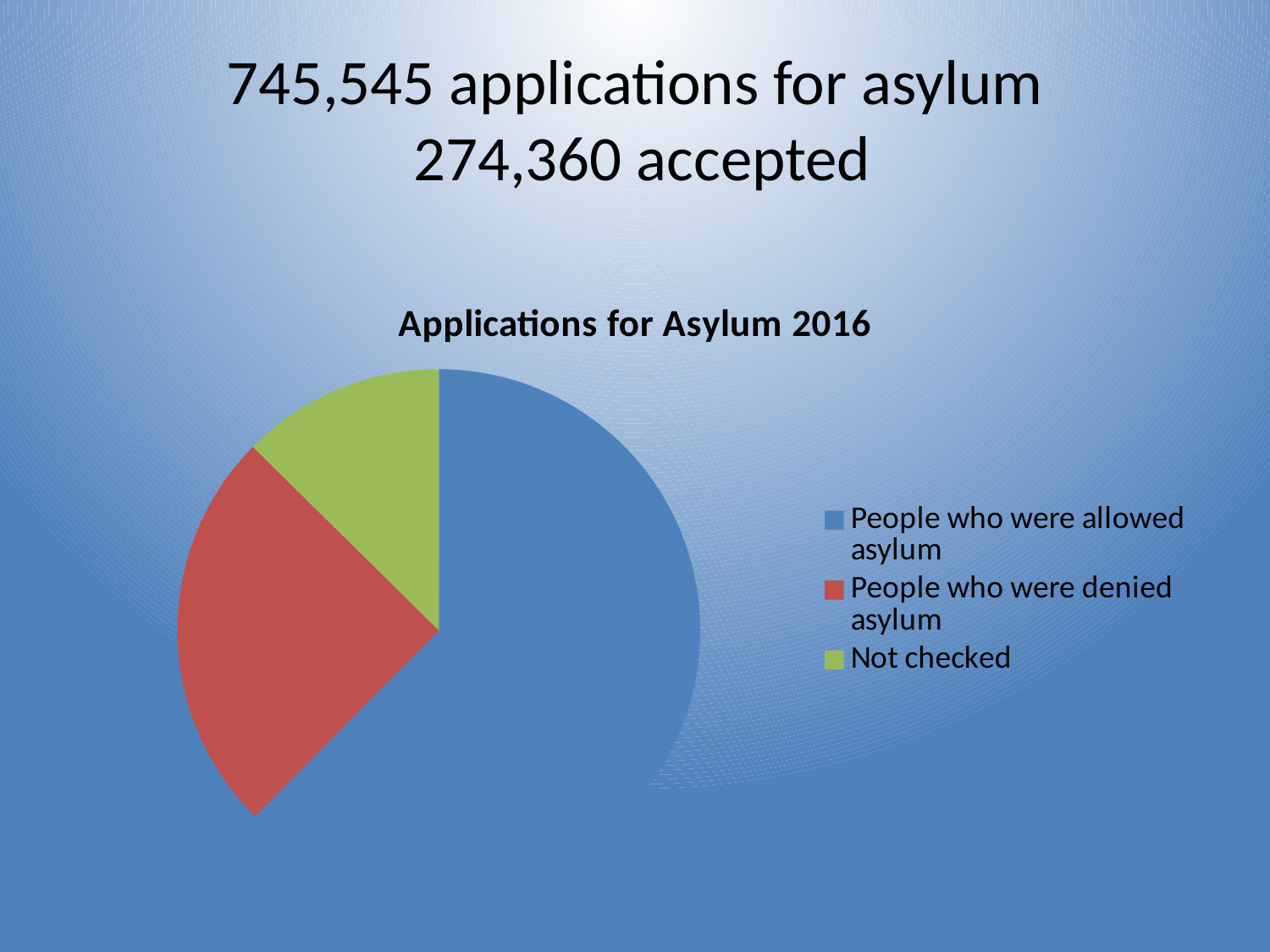
Which category has the largest slice of the pie chart? People who were allowed asylum Does the slice for People who were allowed asylum take up more or less than half of the pie? more What colour is the slice for Not checked? Green How many slices does the pie chart have? 3 What kind of chart is shown on the slide? Pie chart Which category has the smallest slice of the pie chart? Not checked What is the title of the pie chart? Applications for Asylum 2016 Which slice is larger: People who were allowed asylum or People who were denied asylum? People who were allowed asylum Which slice is larger: People who were denied asylum or Not checked? People who were denied asylum How many entries does the legend of the pie chart list? 3